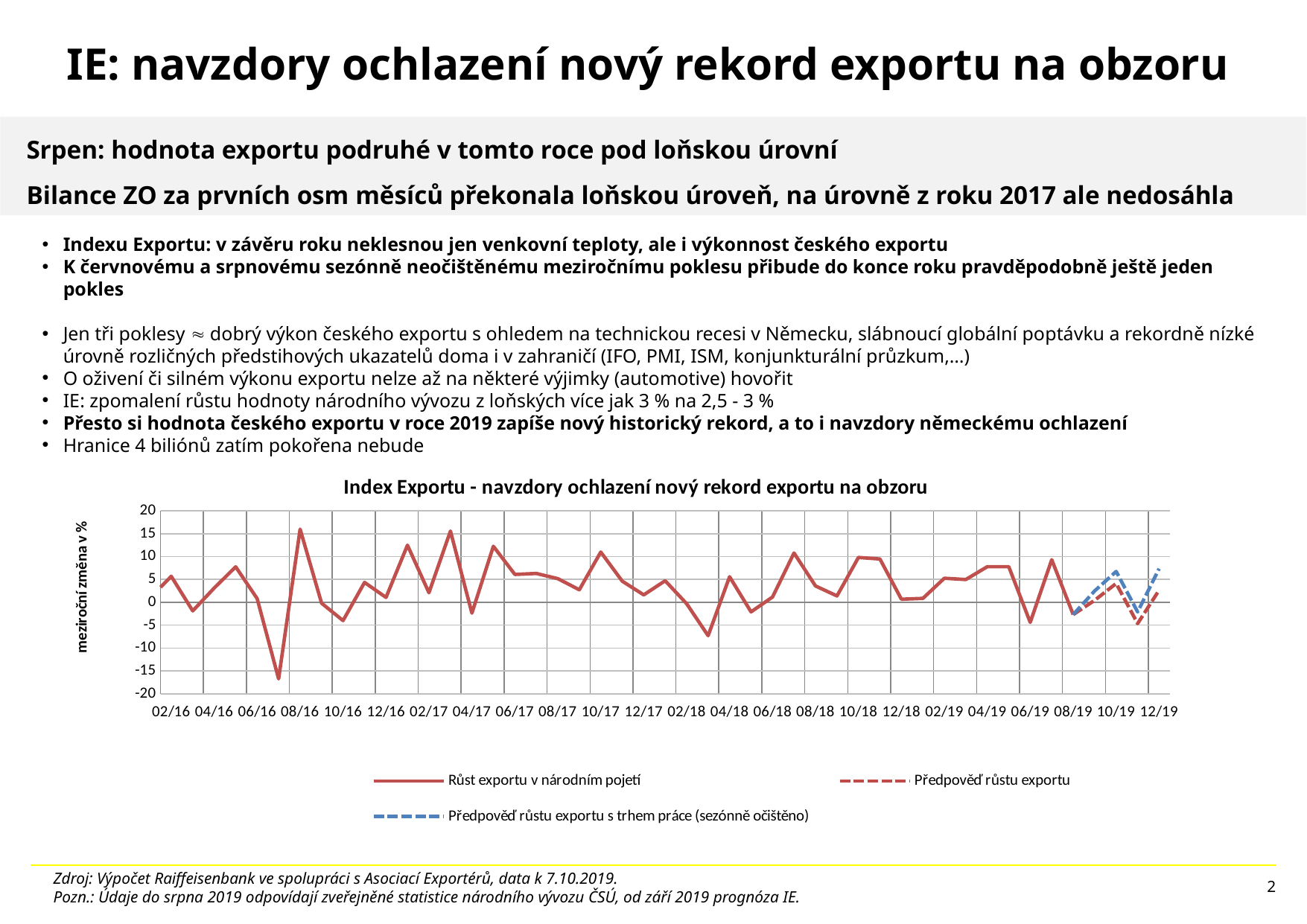
Is the lowest value of the solid red line (Růst exportu v národním pojetí) greater or less than -10? less Is the value of the blue dashed line (Předpověď růstu exportu s trhem práce) at 12/19 greater or less than 0? greater Is the value of the solid red line at 02/19 greater or less than 0? greater What is the label of the vertical axis of the chart? meziroční změna v % What kind of chart is shown on the slide? line chart How many series does the chart legend list? 3 What is the title of the chart? Index Exportu - navzdory ochlazení nový rekord exportu na obzoru